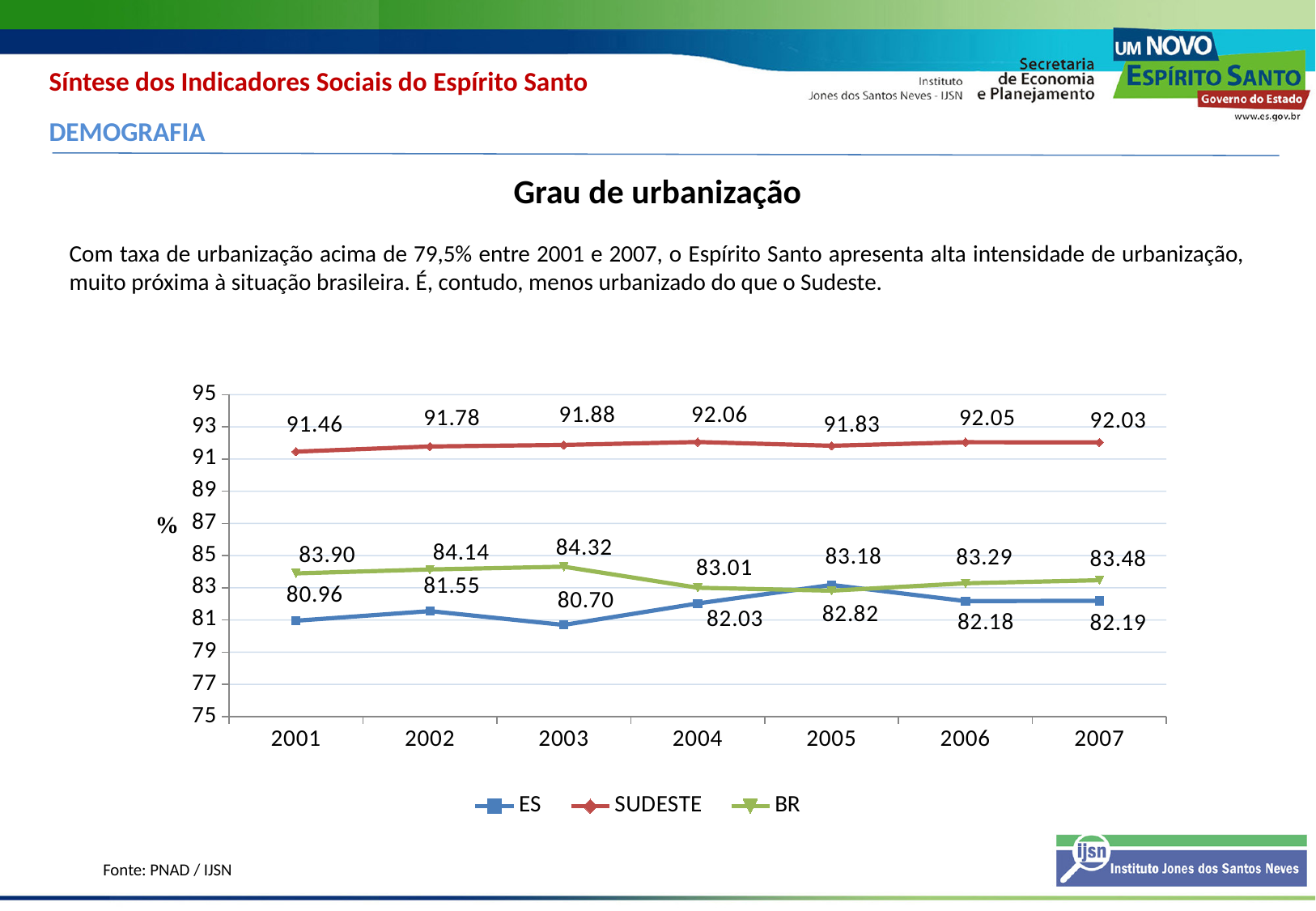
What kind of chart is shown on the slide? Line chart What is the difference between the SUDESTE and ES values in 2007? 9.84 In which year does the SUDESTE series have its lowest value? 2001 How many series does the legend list? 3 What is the value for SUDESTE in 2004? 92.06 What is the value for BR in 2007? 83.48 How many years are plotted on the x axis? 7 In which year does the ES series reach its highest value? 2005 Which is larger for BR: the value in 2001 or the value in 2004? 2001 In which year does the ES series have its lowest value? 2003 In which year does the BR series reach its highest value? 2003 What is the value for ES in 2001? 80.96